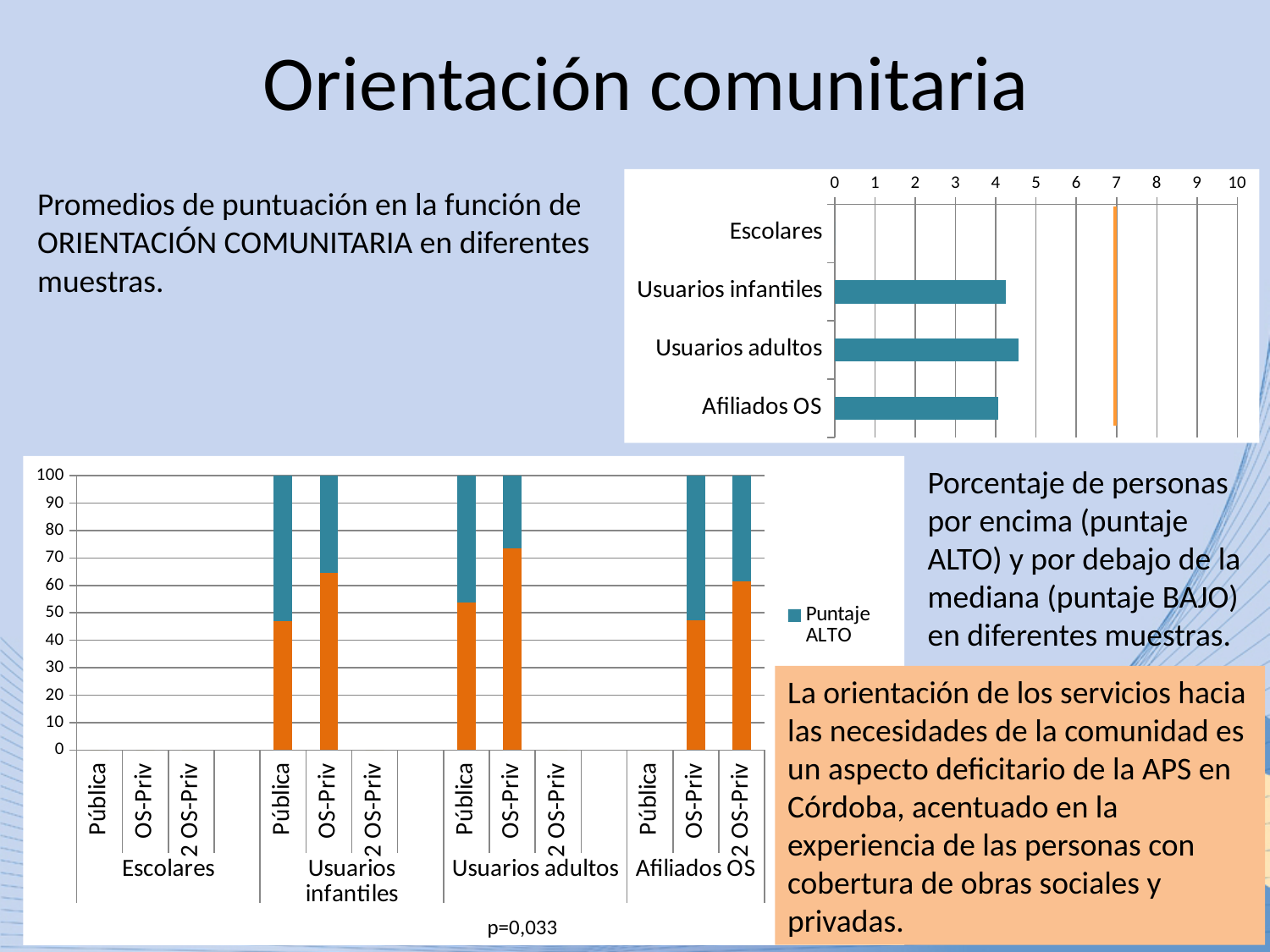
In the top-right chart, is the value for Usuarios adultos greater or less than 5? less What kind of chart is the chart in the bottom left of the slide? stacked bar chart In the bottom-left chart, which series name is shown in the legend? Puntaje ALTO In the top-right chart, which of Usuarios adultos and Afiliados OS has the larger value? Usuarios adultos In the bottom-left chart, is the orange (lower) segment for Usuarios infantiles Pública greater or less than 50? less In the bottom-left chart, how many sample groups are labelled along the x axis? 4 In the top-right chart, how many categories are listed on the vertical axis? 4 What kind of chart is the chart in the top right of the slide? bar chart In the top-right chart, is the value for Usuarios infantiles greater or less than 4? greater In the bottom-left chart, what is the total height of the stacked bar for Usuarios adultos OS-Priv? 100 In the top-right chart, at what value on the horizontal axis is the orange vertical line drawn? 7